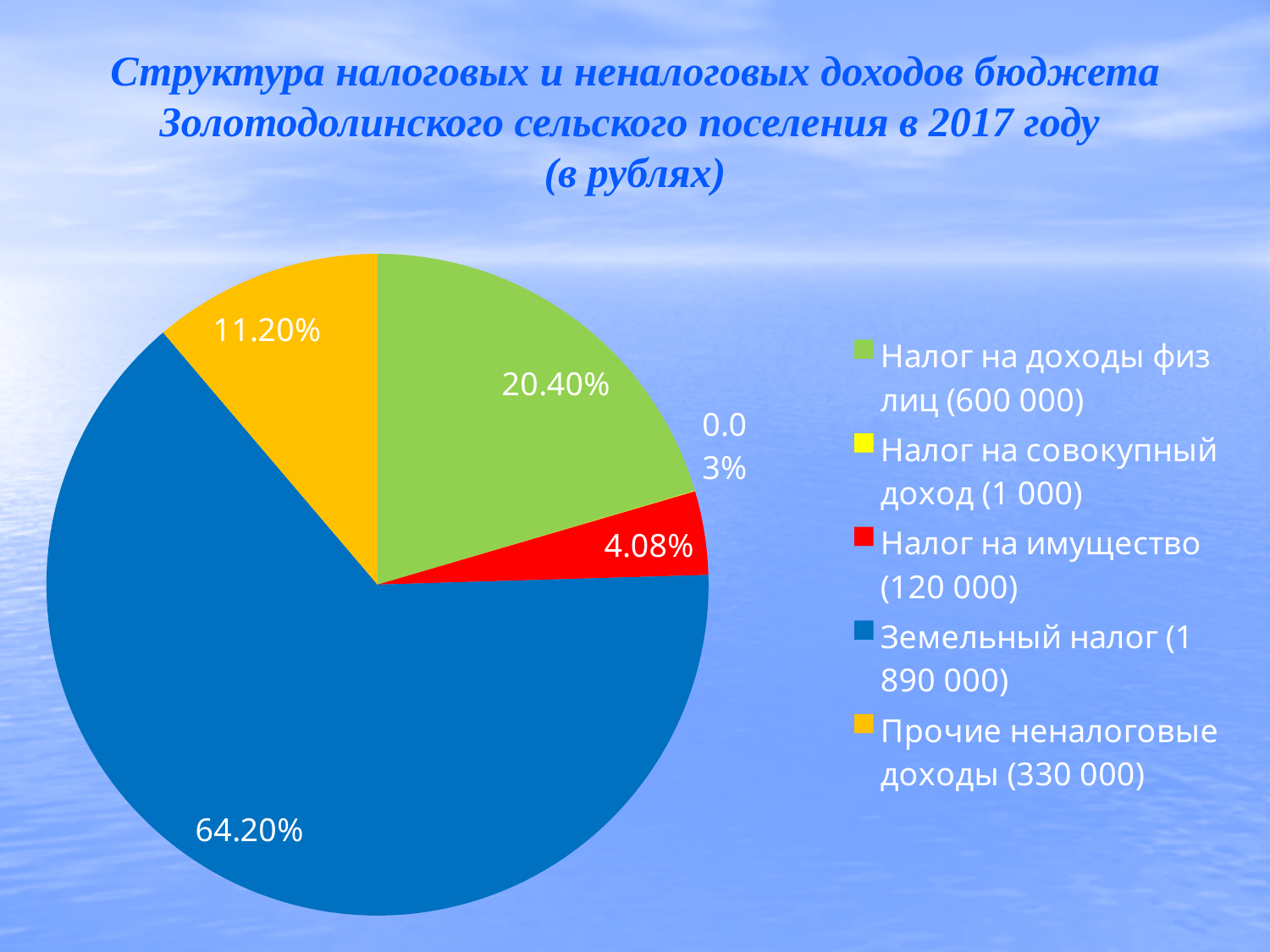
What share of the pie does Прочие неналоговые доходы (330 000) take? 11.20% What colour is the slice for Налог на имущество (120 000)? red What share of the pie does Налог на доходы физ лиц (600 000) take? 20.40% What is the difference in percentage points between the Земельный налог slice and the Налог на доходы физ лиц slice? 43.80 What is the title of the chart on the slide? Структура налоговых и неналоговых доходов бюджета Золотодолинского сельского поселения в 2017 году (в рублях) Which slice is larger: Прочие неналоговые доходы or Налог на имущество? Прочие неналоговые доходы What kind of chart is shown on the slide? pie chart How many categories does the pie chart have? 5 What share of the pie does Земельный налог (1 890 000) take? 64.20% Which category has the smallest slice of the pie? Налог на совокупный доход (1 000) Which category has the largest slice of the pie? Земельный налог (1 890 000)